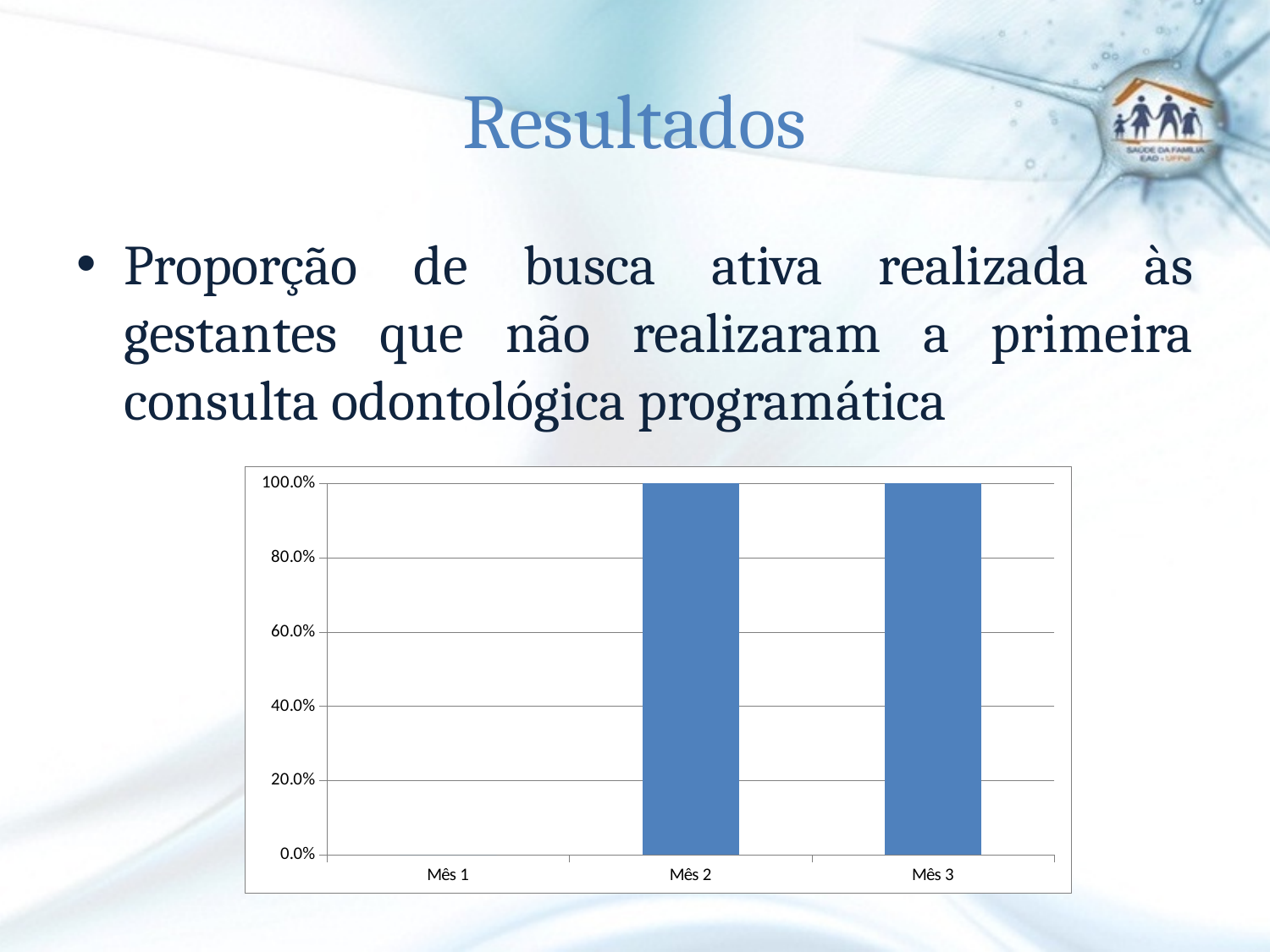
Does the value rise or fall from Mês 1 to Mês 2? rise How many months are shown on the x axis? 3 What kind of chart is shown on the slide? bar chart What is the value for Mês 2? 100.0% Is the value for Mês 3 greater or less than 80.0%? greater Which month has the lowest value? Mês 1 What is the title of the slide containing the chart? Resultados What is the value for Mês 1? 0.0% Which is larger, the value for Mês 1 or the value for Mês 2? Mês 2 What is the value for Mês 3? 100.0% Is the value for Mês 1 greater or less than 20.0%? less What is the difference between the values for Mês 2 and Mês 1? 100.0%